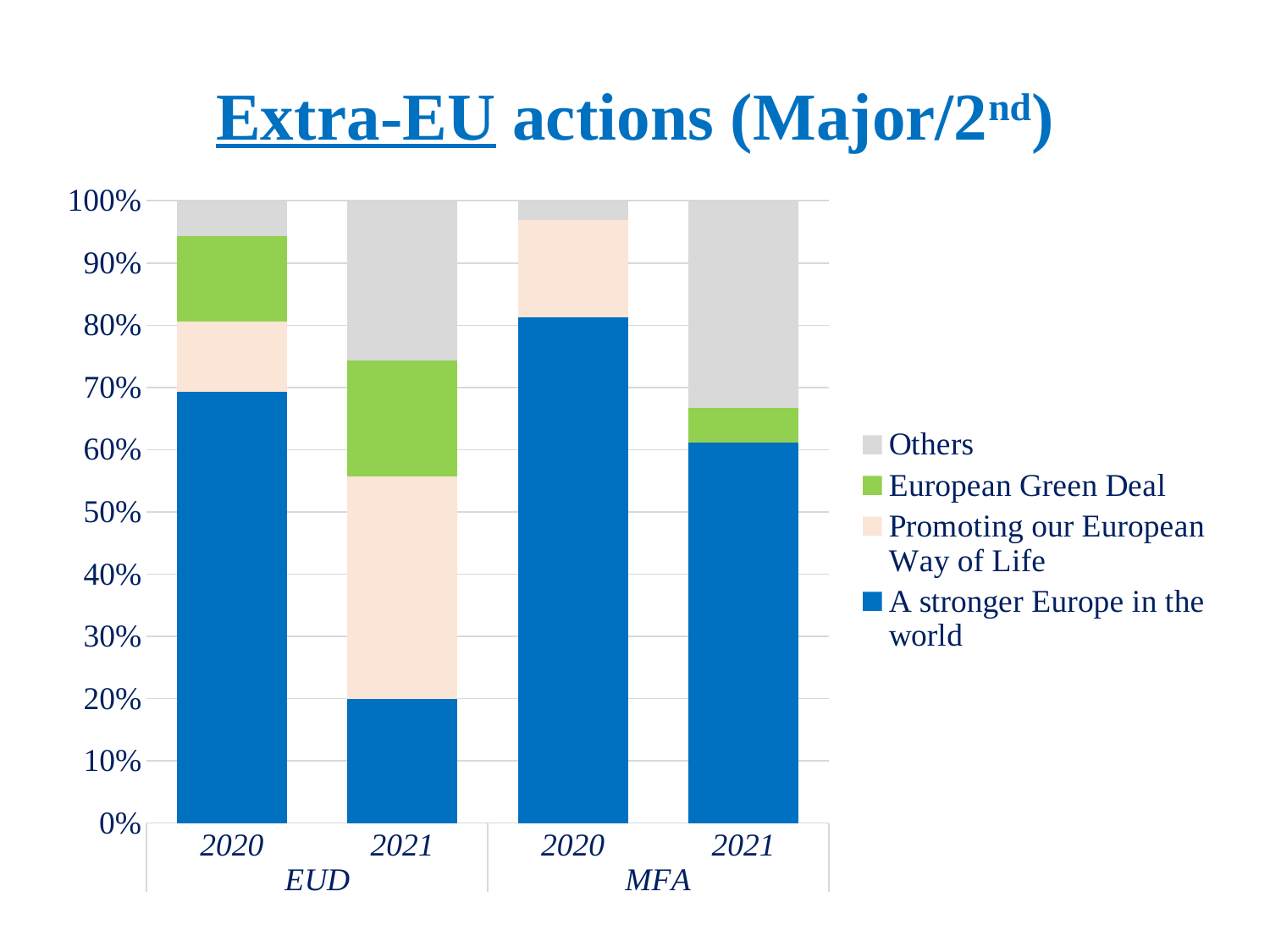
Which legend entry is shown in grey? Others What kind of chart is shown on the slide? Stacked bar chart How many bars are plotted in the chart? 4 Is the value for 'A stronger Europe in the world' in the MFA 2020 bar greater or less than 70%? greater Which bar has the largest 'Promoting our European Way of Life' segment? EUD 2021 Which bar has the smallest share for 'A stronger Europe in the world'? EUD 2021 How many series does the legend list? 4 Which bar has the largest share for 'A stronger Europe in the world'? MFA 2020 What is the title of the slide? Extra-EU actions (Major/2nd) Is the value for 'A stronger Europe in the world' in the EUD 2021 bar greater or less than 30%? less Which is larger: the 'A stronger Europe in the world' share in EUD 2020 or in MFA 2021? EUD 2020 Is the value for 'A stronger Europe in the world' in the EUD 2020 bar greater or less than 60%? greater